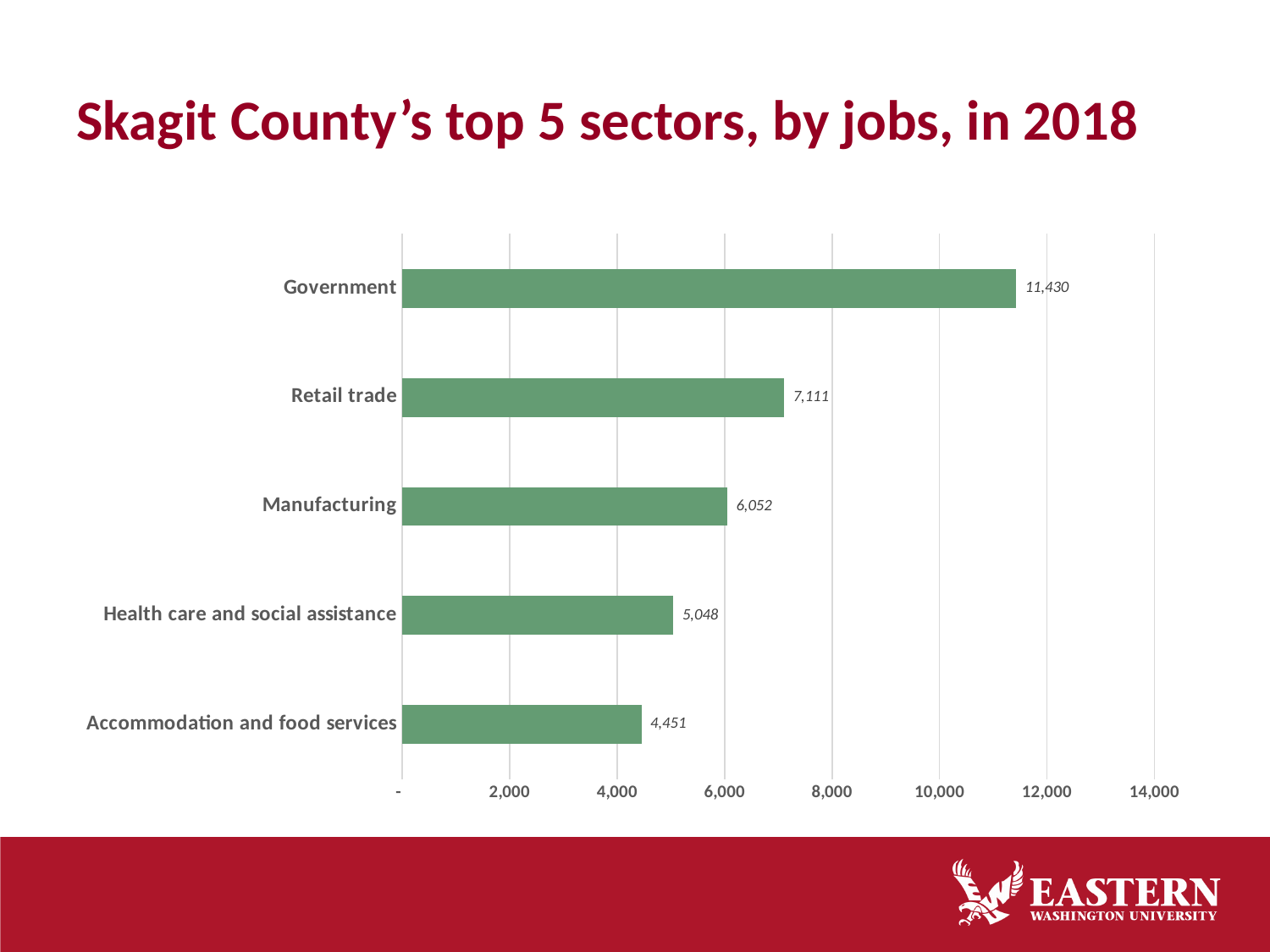
How many sectors are shown in the chart? 5 What type of chart is shown on the slide? Bar chart How many jobs does the Government sector have? 11,430 Which has more jobs, Retail trade or Manufacturing? Retail trade What is the value for Retail trade? 7,111 Which sector has the fewest jobs? Accommodation and food services What is the title of the slide? Skagit County's top 5 sectors, by jobs, in 2018 What is the difference between Manufacturing and Health care and social assistance? 1,004 What is the value for Manufacturing? 6,052 Which sector has the most jobs? Government What is the difference in jobs between Government and Retail trade? 4,319 What is the value for Health care and social assistance? 5,048